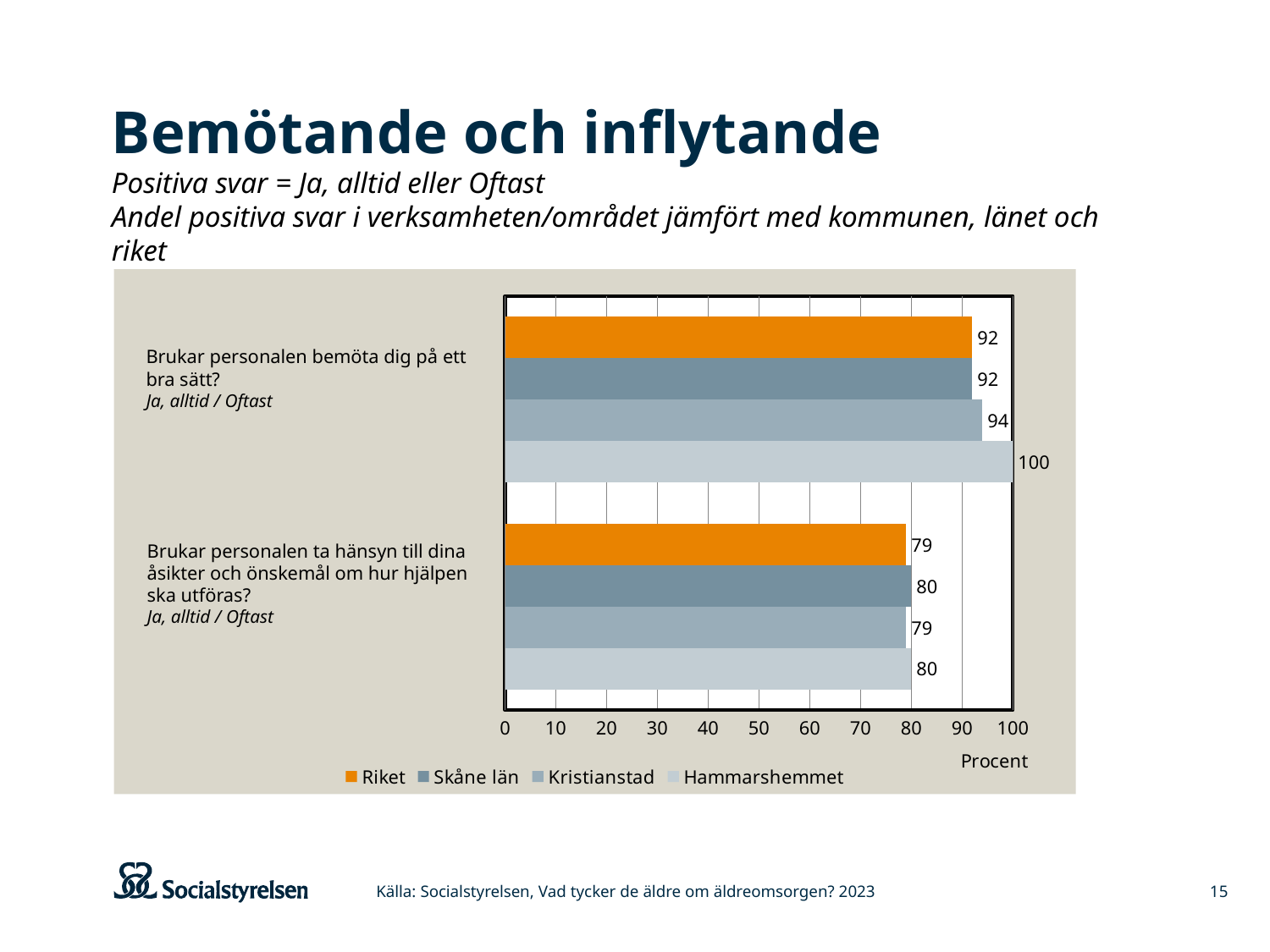
Which is larger for Kristianstad: the value for "Brukar personalen bemöta dig på ett bra sätt?" or for "Brukar personalen ta hänsyn till dina åsikter och önskemål om hur hjälpen ska utföras?"? Brukar personalen bemöta dig på ett bra sätt? What is the value for Riket for the question "Brukar personalen ta hänsyn till dina åsikter och önskemål om hur hjälpen ska utföras?"? 79 Which series has the highest value for the question "Brukar personalen bemöta dig på ett bra sätt?"? Hammarshemmet How many question categories are plotted on the chart? 2 How many series does the legend list? 4 What kind of chart is shown on the slide? Bar chart What label is shown on the horizontal axis of the chart? Procent What is the value for Kristianstad for the question "Brukar personalen bemöta dig på ett bra sätt?"? 94 What is the difference between Hammarshemmet's values for the two questions? 20 What is the value for Skåne län for the question "Brukar personalen ta hänsyn till dina åsikter och önskemål om hur hjälpen ska utföras?"? 80 What is the difference between Hammarshemmet and Riket for the question "Brukar personalen bemöta dig på ett bra sätt?"? 8 What is the value for Hammarshemmet for the question "Brukar personalen bemöta dig på ett bra sätt?"? 100